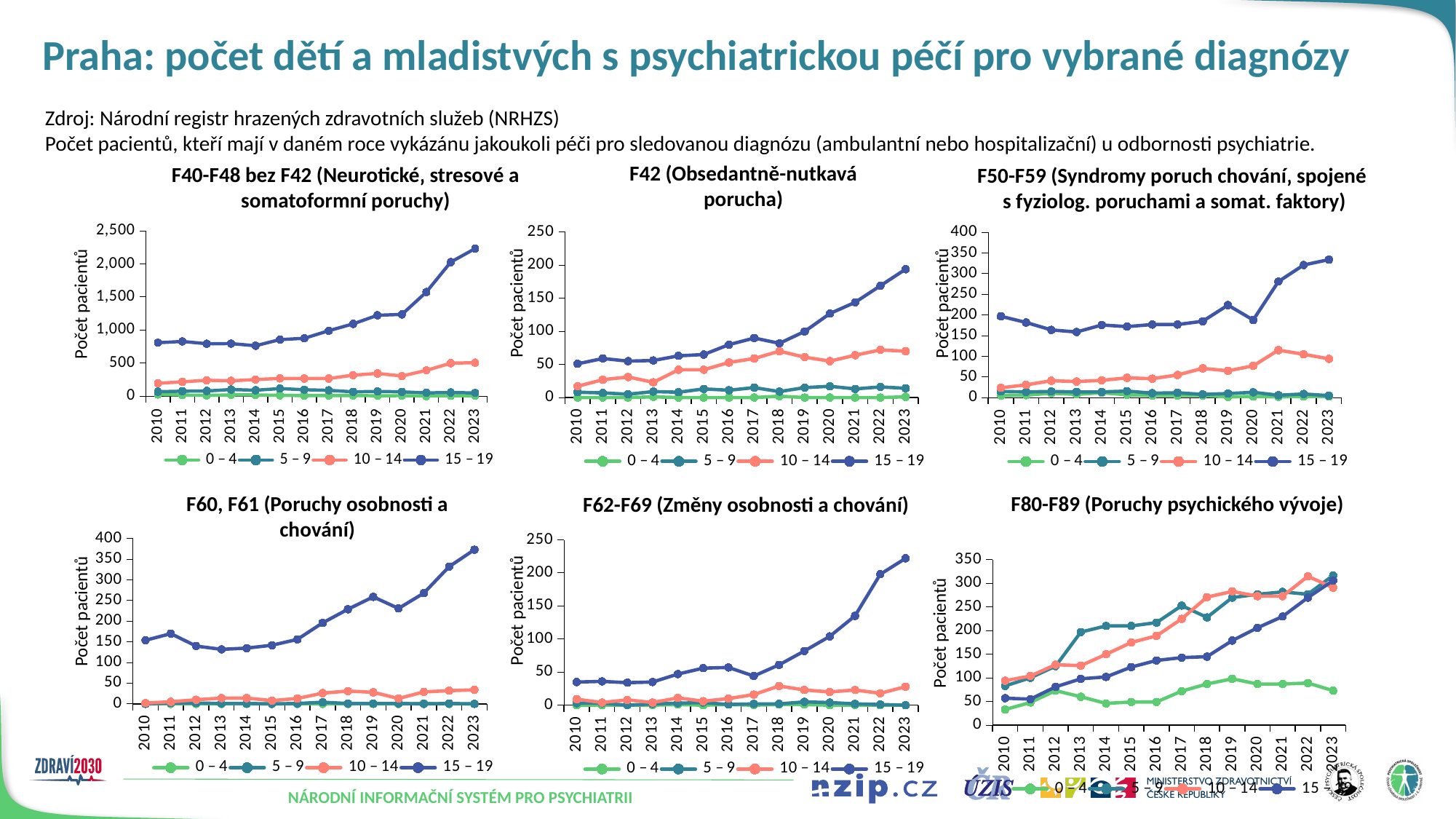
In the 'F40-F48 bez F42' chart, which age group has the highest value in 2010? 15 – 19 In the 'F50-F59' chart, which age group has the highest value in 2023? 15 – 19 In the 'F80-F89 (Poruchy psychického vývoje)' chart, is the value for the 0 – 4 group in 2019 greater or less than 150? less What kind of chart is the 'F42 (Obsedantně-nutkavá porucha)' chart? line chart What is the y-axis label on the 'F62-F69 (Změny osobnosti a chování)' chart? Počet pacientů How many years are plotted on the x axis of the 'F60, F61 (Poruchy osobnosti a chování)' chart? 14 In the 'F50-F59' chart, is the value for the 15 – 19 group in 2021 greater or less than 250? greater How many series does the legend of the 'F40-F48 bez F42' chart list? 4 In the 'F42 (Obsedantně-nutkavá porucha)' chart, is the value for the 15 – 19 group in 2023 greater or less than 150? greater In the 'F80-F89 (Poruchy psychického vývoje)' chart, which is larger in 2013: the 5 – 9 group or the 10 – 14 group? 5 – 9 In the 'F60, F61 (Poruchy osobnosti a chování)' chart, does the 15 – 19 line rise or fall from 2014 to 2023? rise